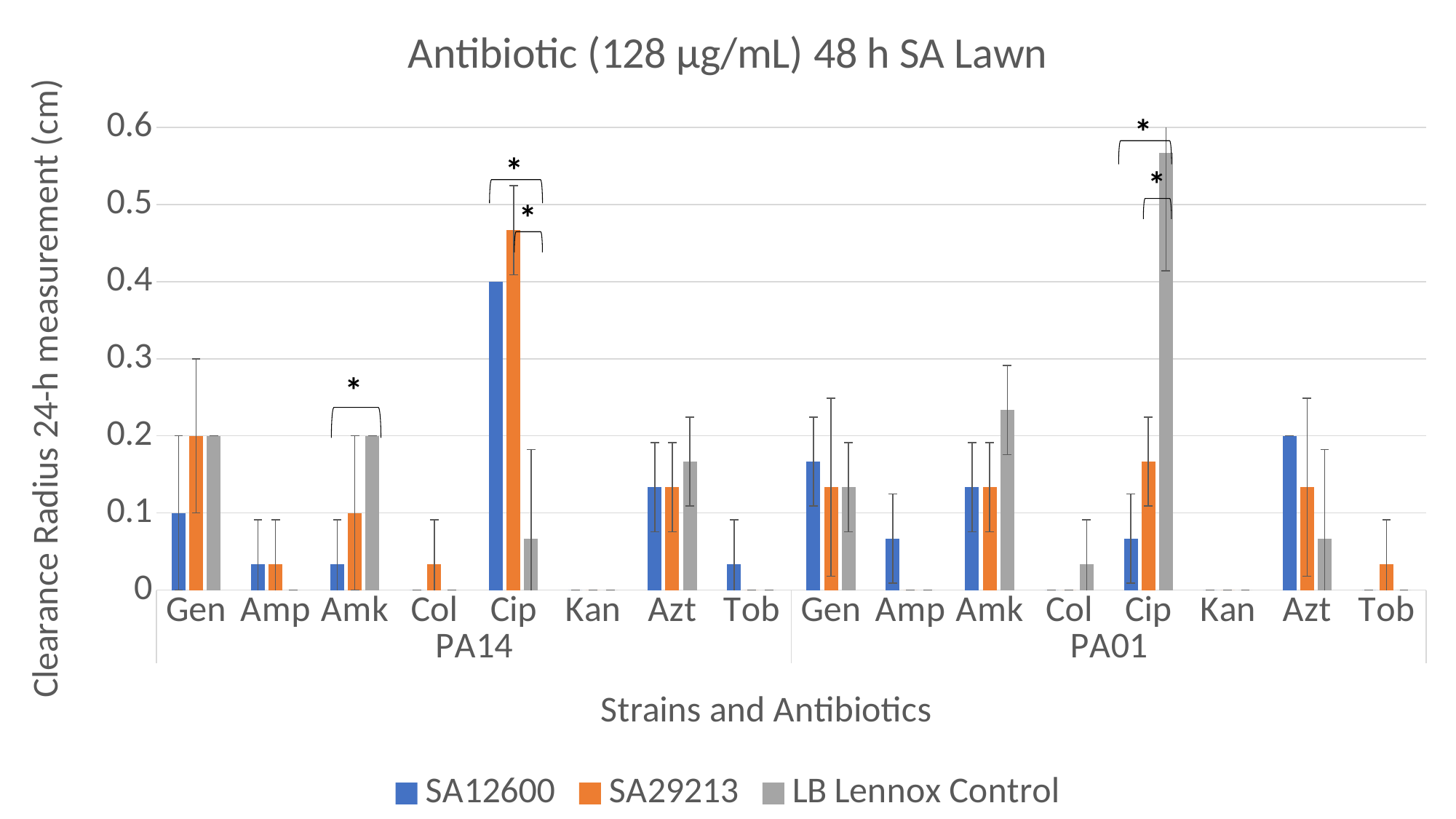
What is the title of the chart? Antibiotic (128 µg/mL) 48 h SA Lawn What type of chart is shown on the slide? bar chart Which series has the highest value for Cip in the PA14 group? SA29213 Is the SA29213 value for Cip in the PA14 group greater or less than 0.4? greater Is the LB Lennox Control value for Amk in the PA01 group greater or less than 0.3? less How many antibiotic categories are shown within the PA14 group? 8 Which series has the highest value for Cip in the PA01 group? LB Lennox Control How many series does the legend list? 3 Is the LB Lennox Control value for Cip in the PA01 group greater or less than 0.5? greater What is the SA12600 value for Azt in the PA01 group? 0.2 What is the SA12600 value for Cip in the PA14 group? 0.4 For Cip in the PA14 group, which is larger: the SA12600 value or the LB Lennox Control value? SA12600